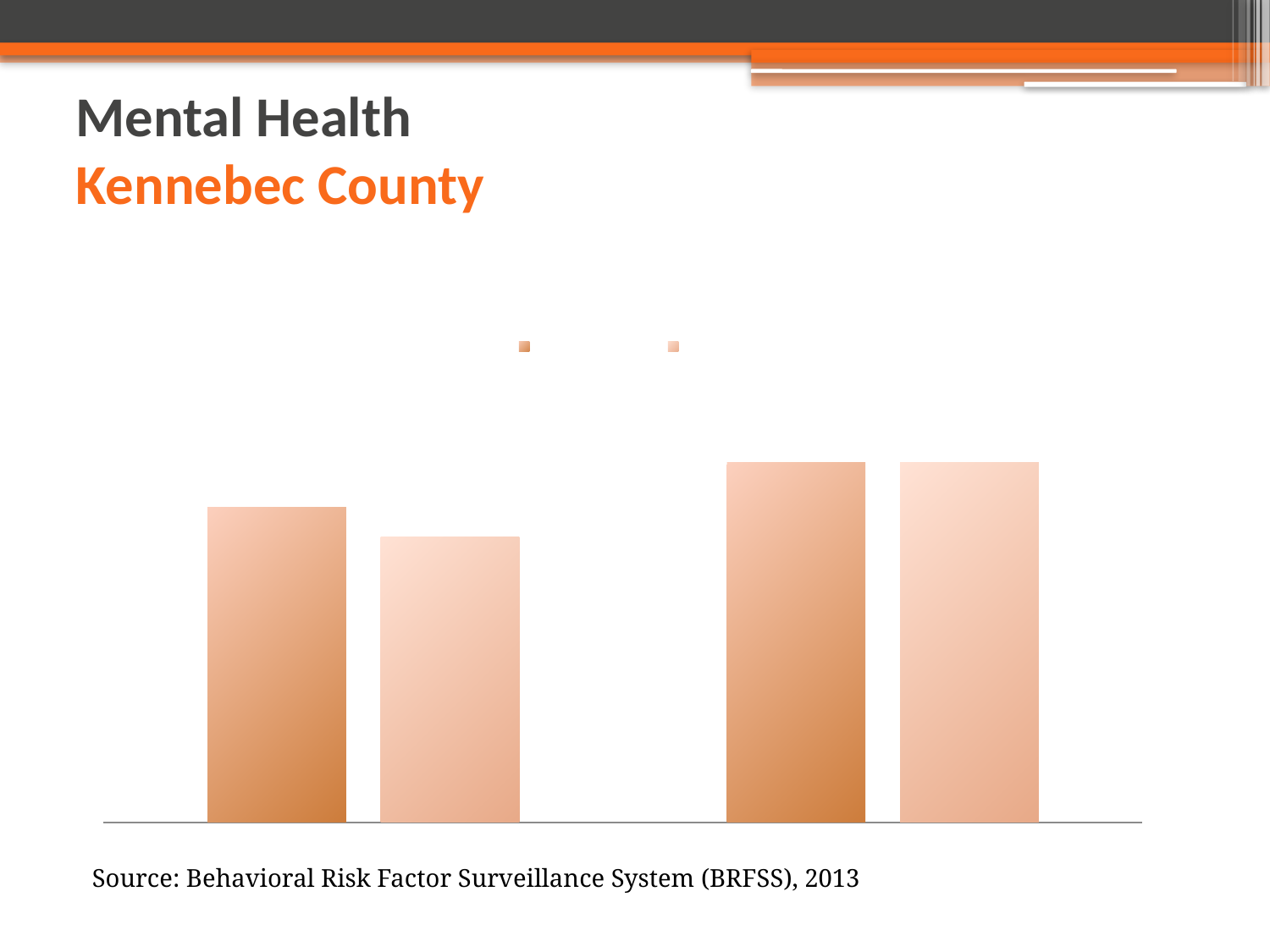
What kind of chart is shown on the slide? bar chart How many series does the chart's legend list? 2 What is the source cited below the chart? Behavioral Risk Factor Surveillance System (BRFSS), 2013 Which group of bars is taller, the left group or the right group? the right group How many bars are plotted in the chart? 4 In the left group of bars, is the darker orange bar taller or shorter than the lighter bar? taller Which county is named in the slide title? Kennebec County How many groups of bars are shown in the chart? 2